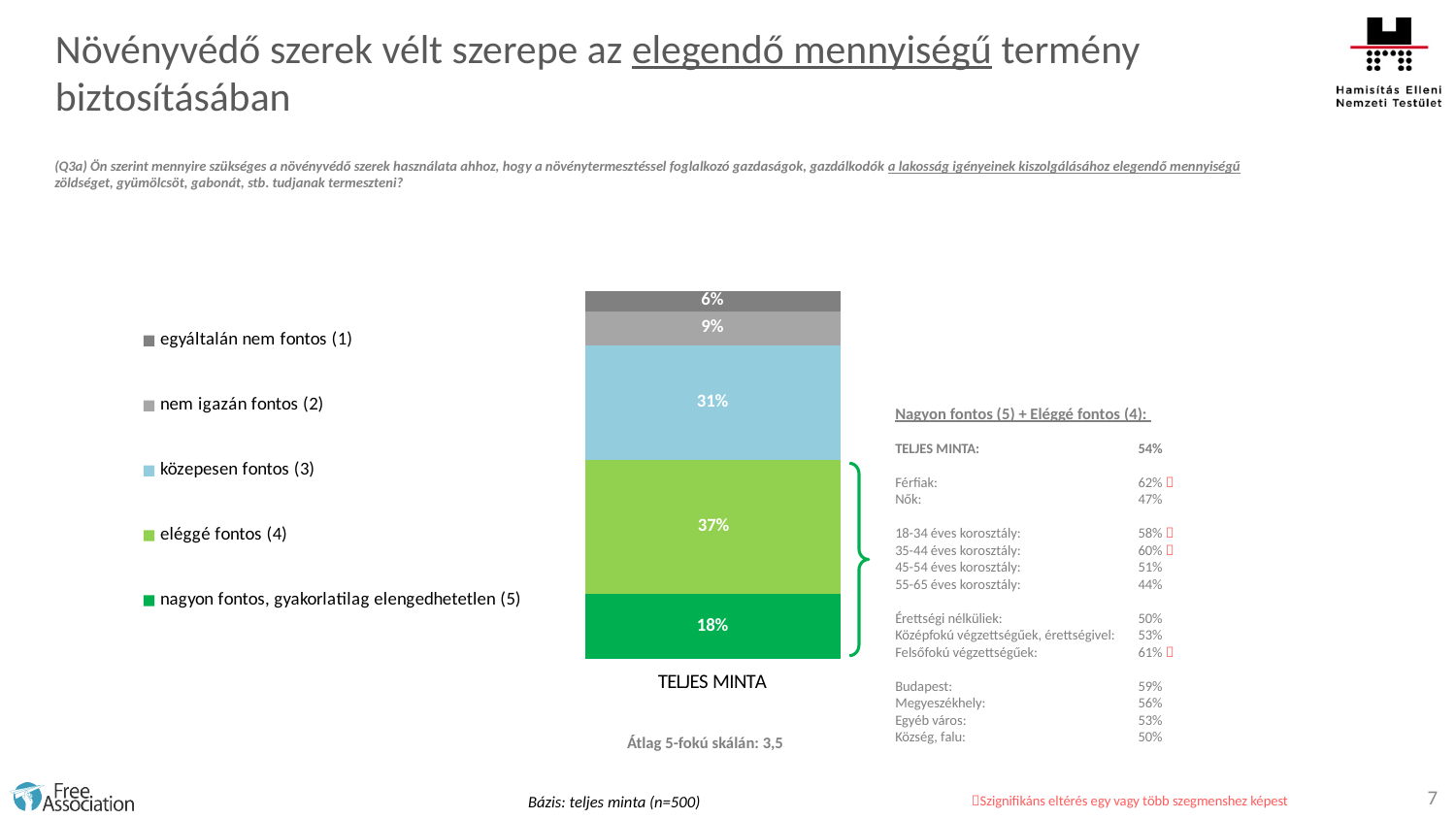
Which response category has the smallest share in the TELJES MINTA bar? egyáltalán nem fontos (1) Which response category has the largest share in the TELJES MINTA bar? eléggé fontos (4) What is the value for "nem igazán fontos (2)" in the TELJES MINTA bar? 9% Which is larger: the value for "közepesen fontos (3)" or for "eléggé fontos (4)"? eléggé fontos (4) How many bars (categories) are plotted in the chart? 1 How many series does the chart legend list? 5 What is the value for "eléggé fontos (4)" in the TELJES MINTA bar? 37% What is the value for "egyáltalán nem fontos (1)" in the TELJES MINTA bar? 6% What kind of chart is shown on the slide? Stacked bar chart What is the value for "közepesen fontos (3)" in the TELJES MINTA bar? 31% What is the value for "nagyon fontos, gyakorlatilag elengedhetetlen (5)" in the TELJES MINTA bar? 18% What is the difference between the "eléggé fontos (4)" and "nagyon fontos, gyakorlatilag elengedhetetlen (5)" values? 19 percentage points